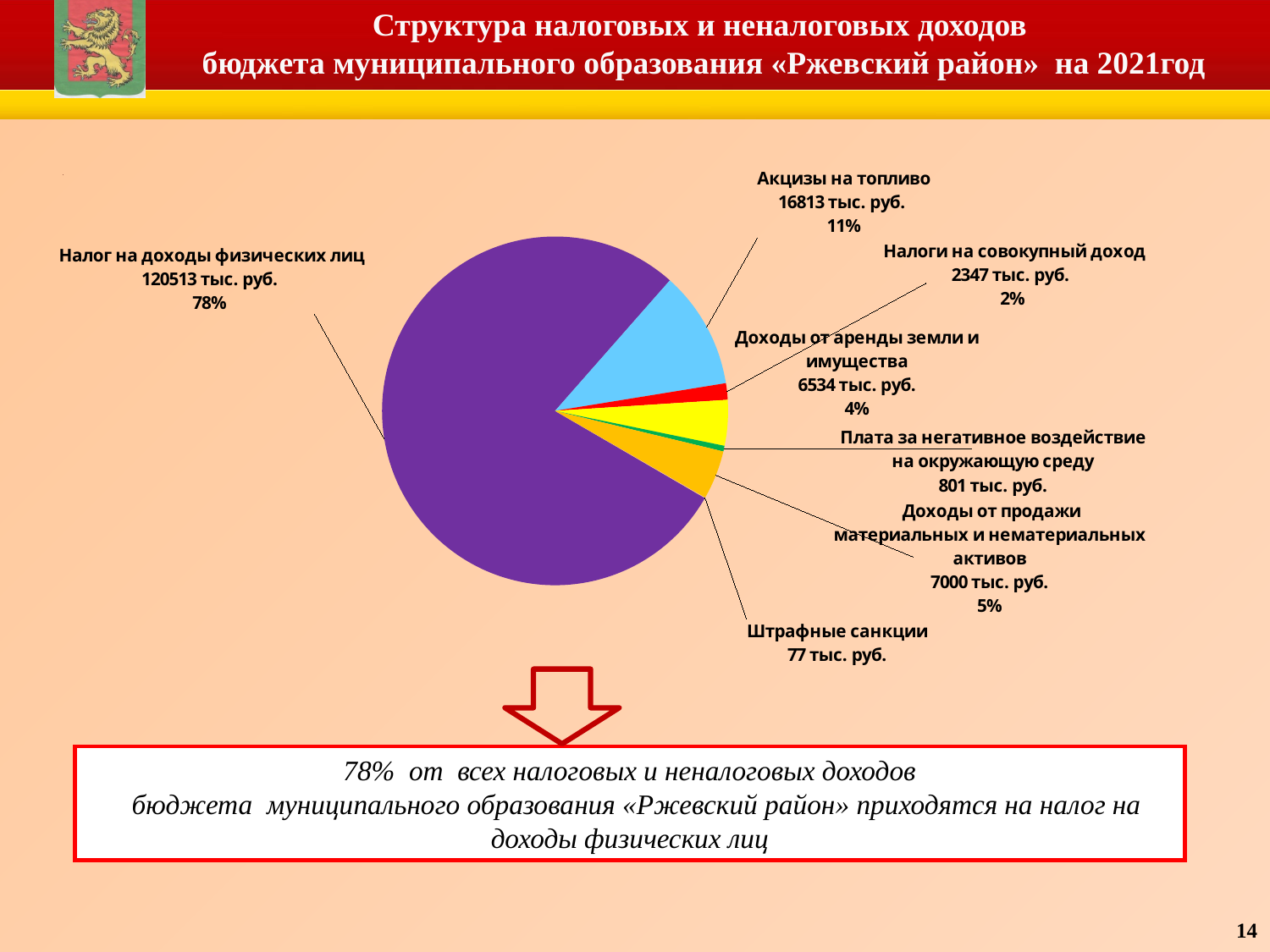
Which is larger: Доходы от продажи материальных и нематериальных активов or Доходы от аренды земли и имущества? Доходы от продажи материальных и нематериальных активов What is the value for Штрафные санкции? 77 тыс. руб. What is the difference between Доходы от аренды земли и имущества and Налоги на совокупный доход? 4187 тыс. руб. Which category has the largest slice of the pie? Налог на доходы физических лиц How many slices does the pie chart have? 7 What is the value for Акцизы на топливо? 16813 тыс. руб. Which category has the smallest slice of the pie? Штрафные санкции What is the value for Налог на доходы физических лиц? 120513 тыс. руб. What is the value for Доходы от продажи материальных и нематериальных активов? 7000 тыс. руб. What share of the pie does Акцизы на топливо take? 11% What share of the pie does Налог на доходы физических лиц take? 78% What kind of chart is shown on the slide? Pie chart